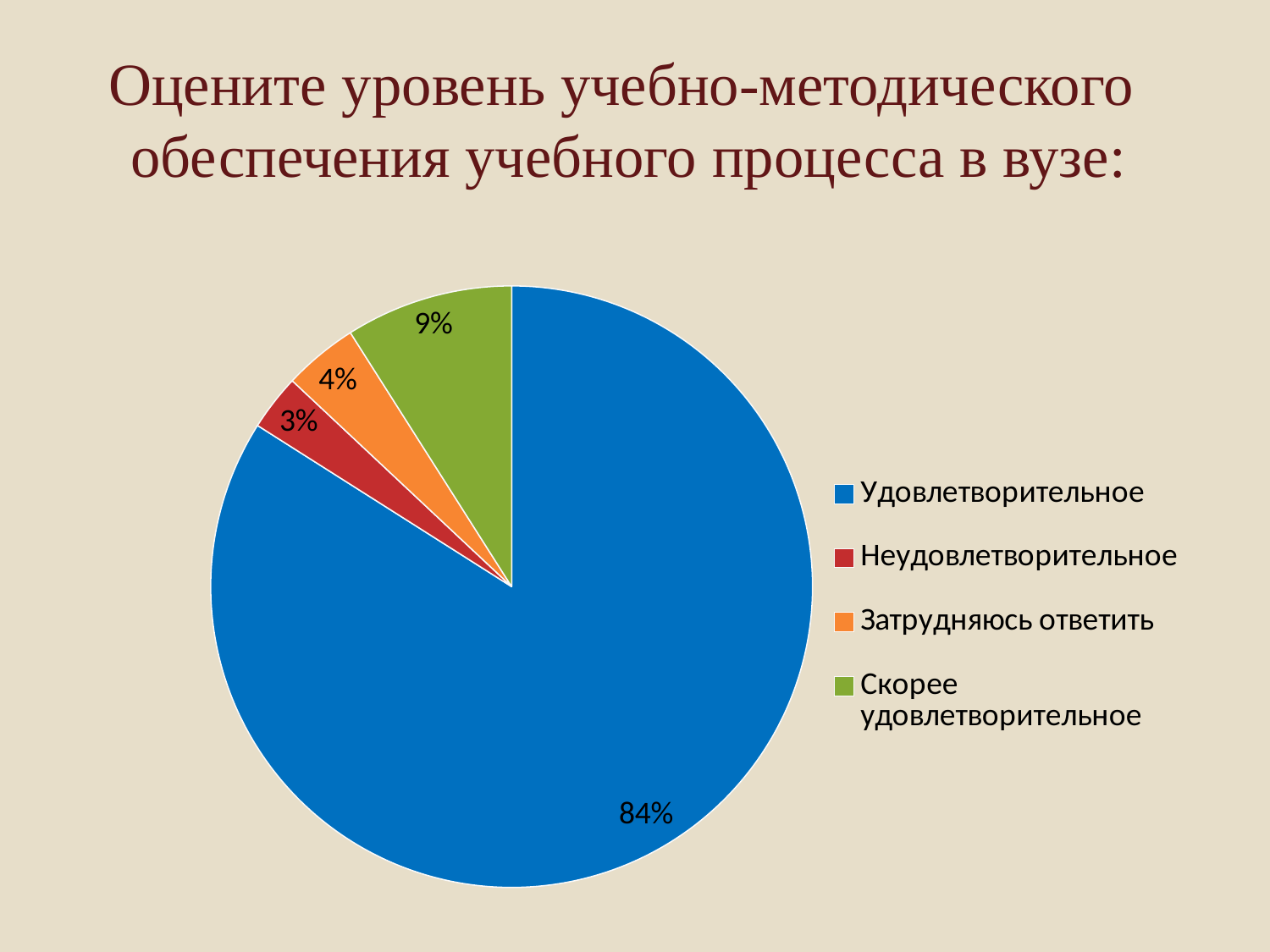
What is the difference between Затрудняюсь ответить and Неудовлетворительное? 1% Which is larger, Скорее удовлетворительное or Затрудняюсь ответить? Скорее удовлетворительное What is the value for Затрудняюсь ответить? 4% What share of the pie does Удовлетворительное take? 84% What is the value for Скорее удовлетворительное? 9% Which category has the largest slice? Удовлетворительное How many categories does the pie chart show? 4 What kind of chart is shown on the slide? Pie chart What is the difference between Удовлетворительное and Скорее удовлетворительное? 75% What colour is the slice for Скорее удовлетворительное? Green Which category has the smallest slice? Неудовлетворительное What is the value for Неудовлетворительное? 3%